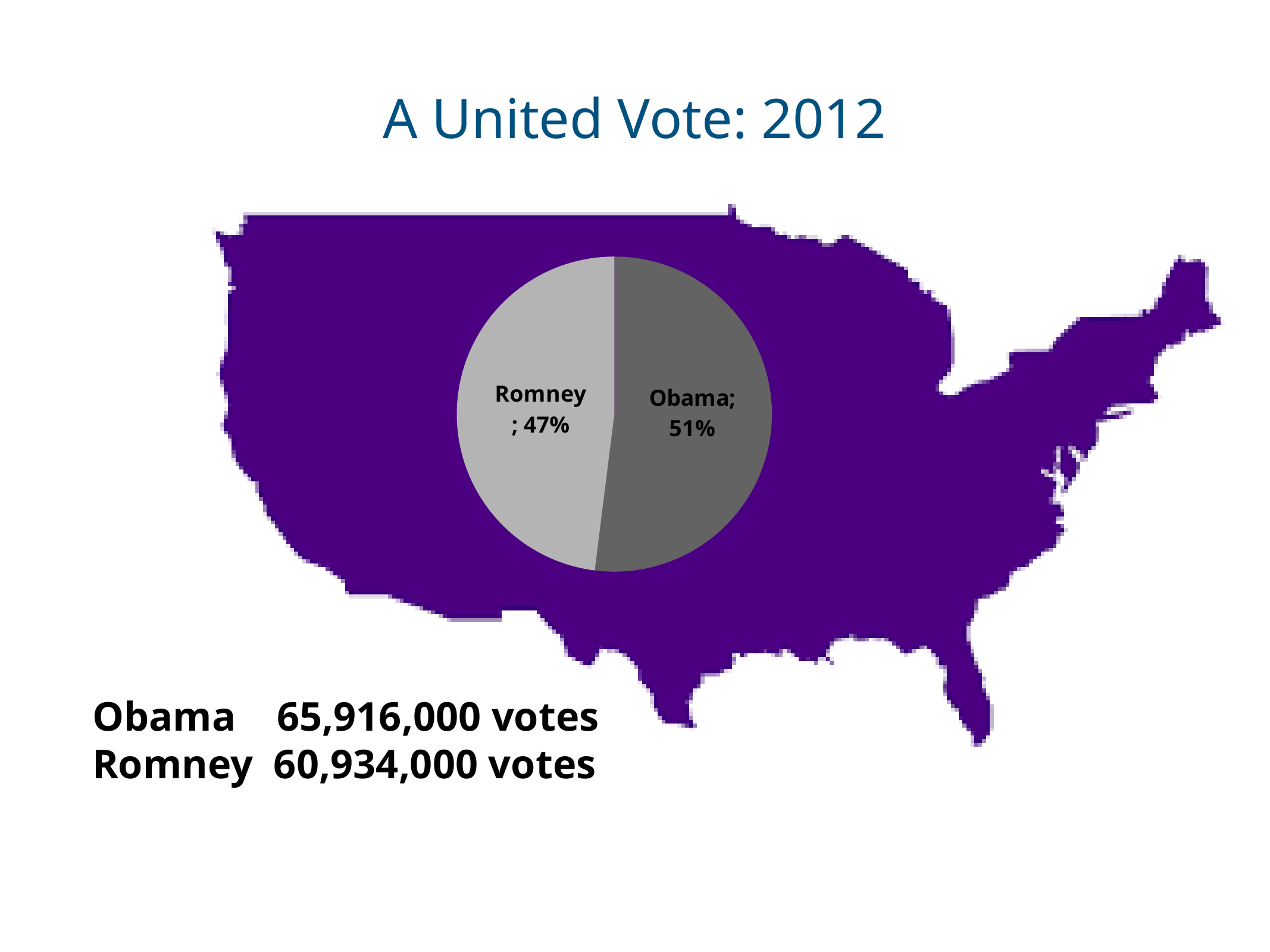
What percentage of the pie is labelled for Obama? 51% Which slice of the pie is the largest? Obama What percentage of the pie is labelled for Romney? 47% Which slice is larger, Obama or Romney? Obama What is the title of the slide containing the pie chart? A United Vote: 2012 Which slice of the pie is shown in the darker grey colour? Obama According to the text on the slide, how many votes did Obama receive? 65,916,000 votes What kind of chart is shown on the slide? Pie chart Which slice of the pie is the smallest? Romney What is the difference in percentage points between the Obama slice and the Romney slice? 4 percentage points According to the text on the slide, how many votes did Romney receive? 60,934,000 votes How many slices does the pie chart have? 2